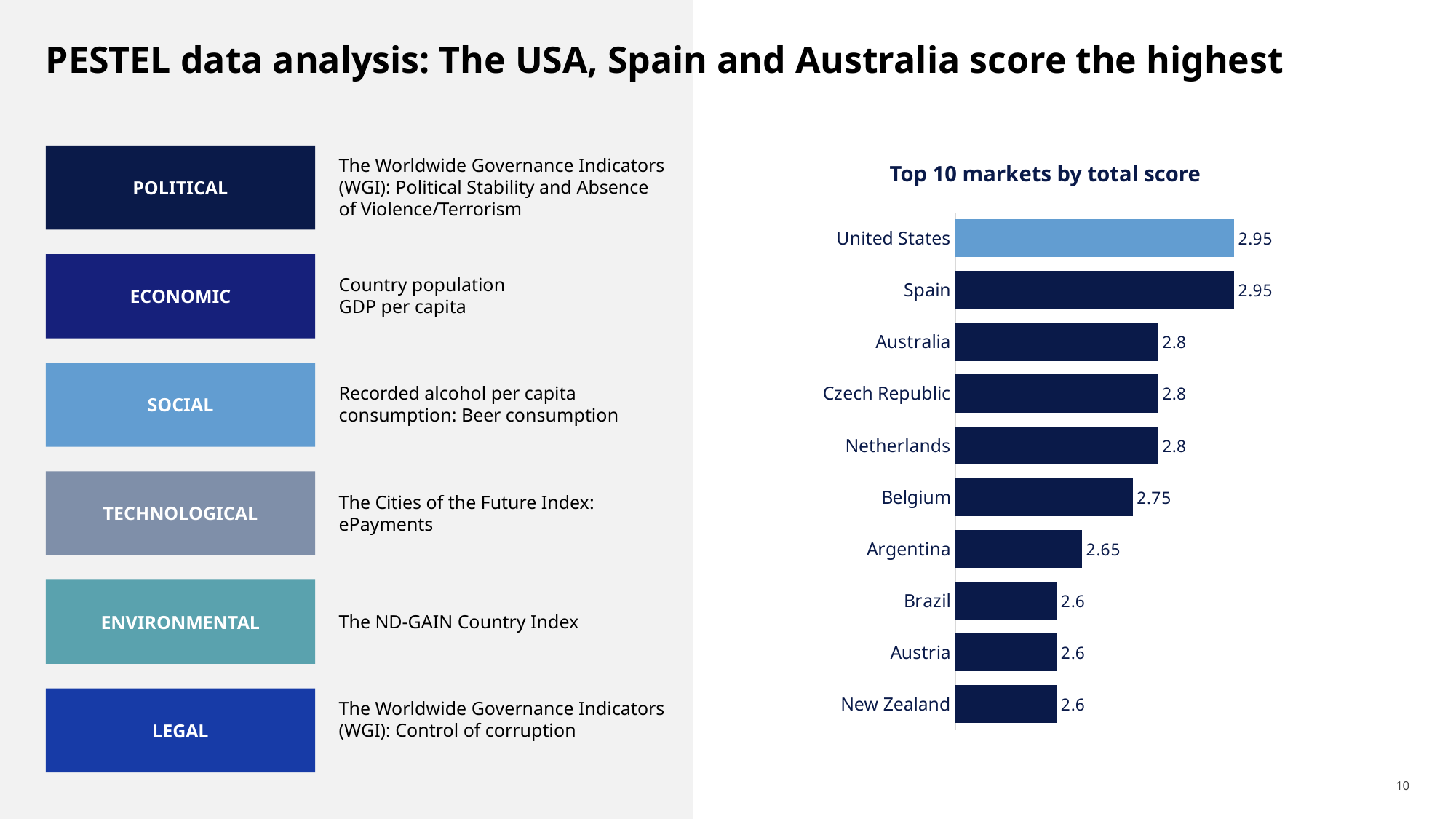
What is the total score for New Zealand? 2.6 How many markets are shown in the chart? 10 Which has a higher total score, Belgium or Argentina? Belgium What is the total score for Argentina? 2.65 Which market has the lowest total score shown in the chart? Brazil, Austria and New Zealand (2.6) What is the difference between the total scores of Australia and Argentina? 0.15 Which has a higher total score, Spain or Netherlands? Spain What is the difference between the total scores of the United States and Brazil? 0.35 What kind of chart is used to show the top 10 markets by total score? Bar chart What is the total score for Spain? 2.95 What is the title of the chart? Top 10 markets by total score What is the total score for Belgium? 2.75